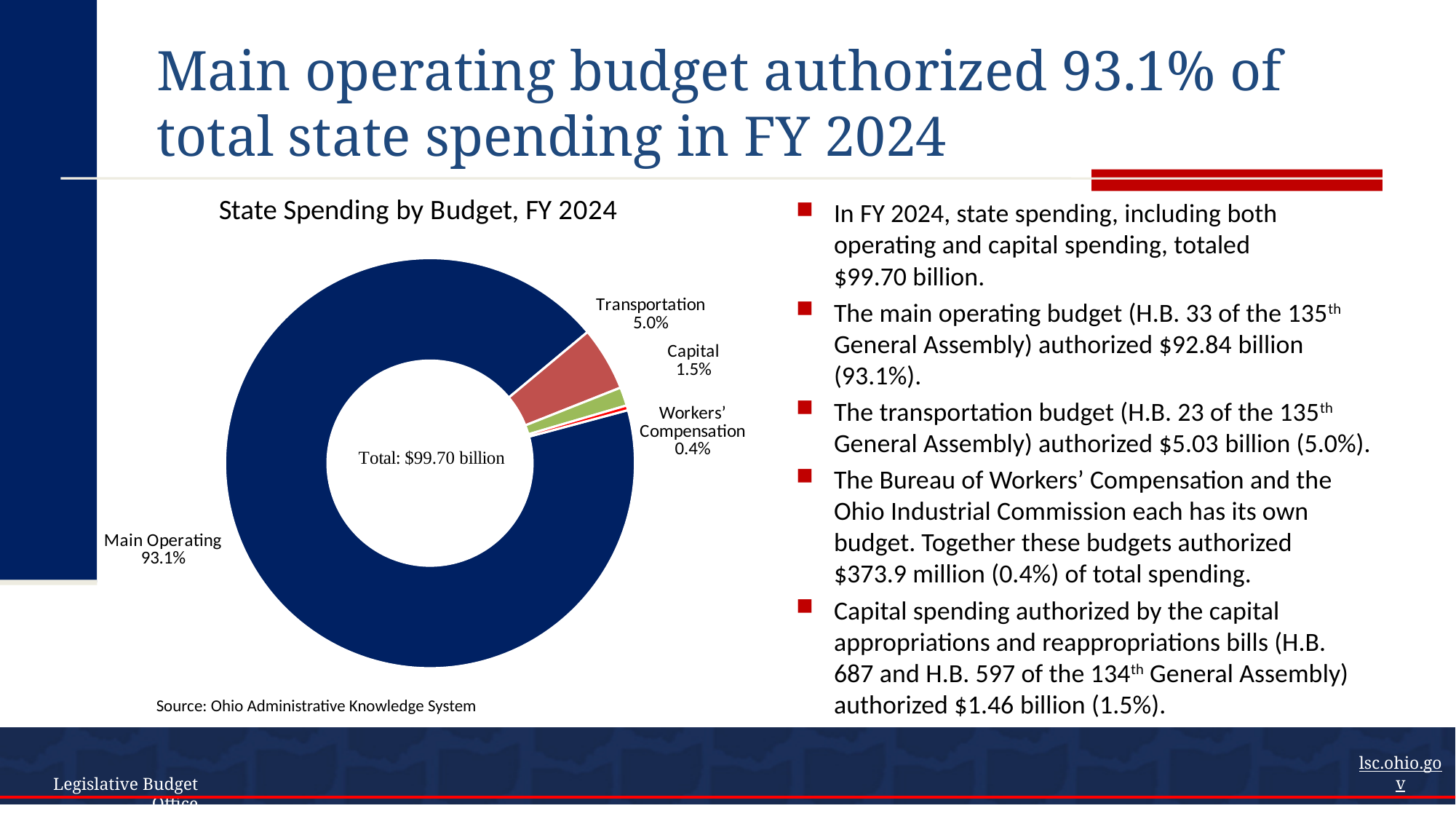
Which budget category has the largest share in the chart? Main Operating Which has a larger share, Capital or Workers' Compensation? Capital What share of state spending does the Transportation budget account for in the chart? 5.0% What is the title of the chart? State Spending by Budget, FY 2024 What share of state spending does the Capital budget account for in the chart? 1.5% What share of state spending does Workers' Compensation account for in the chart? 0.4% What is the difference in percentage points between the Transportation share and the Capital share? 3.5 What share of state spending does the Main Operating budget account for in the chart? 93.1% What kind of chart is shown on the slide? Pie chart (donut) Which budget category has the smallest share in the chart? Workers' Compensation What total is printed in the centre of the chart? Total: $99.70 billion How many budget categories are shown in the chart? 4